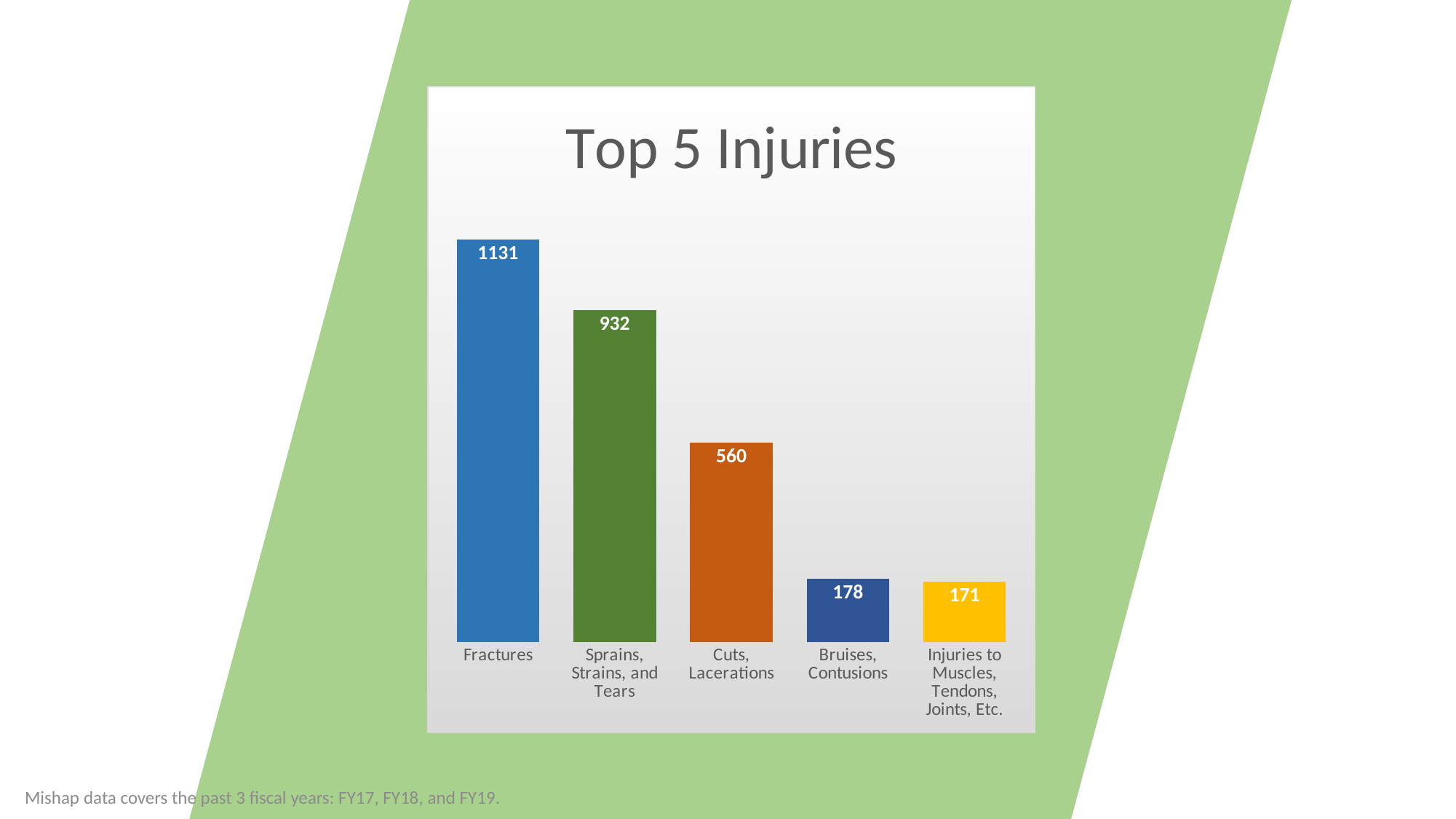
Which is larger, the value for Sprains, Strains, and Tears or the value for Cuts, Lacerations? Sprains, Strains, and Tears Which injury category has the highest value? Fractures How many injury categories are shown in the chart? 5 What is the difference between the values for Fractures and Sprains, Strains, and Tears? 199 What is the value for Sprains, Strains, and Tears? 932 What is the difference between the values for Cuts, Lacerations and Bruises, Contusions? 382 What is the value for Cuts, Lacerations? 560 What is the value for Bruises, Contusions? 178 Which injury category has the lowest value? Injuries to Muscles, Tendons, Joints, Etc. What kind of chart is shown on the slide? Bar chart What is the value for Fractures? 1131 What is the value for Injuries to Muscles, Tendons, Joints, Etc.? 171